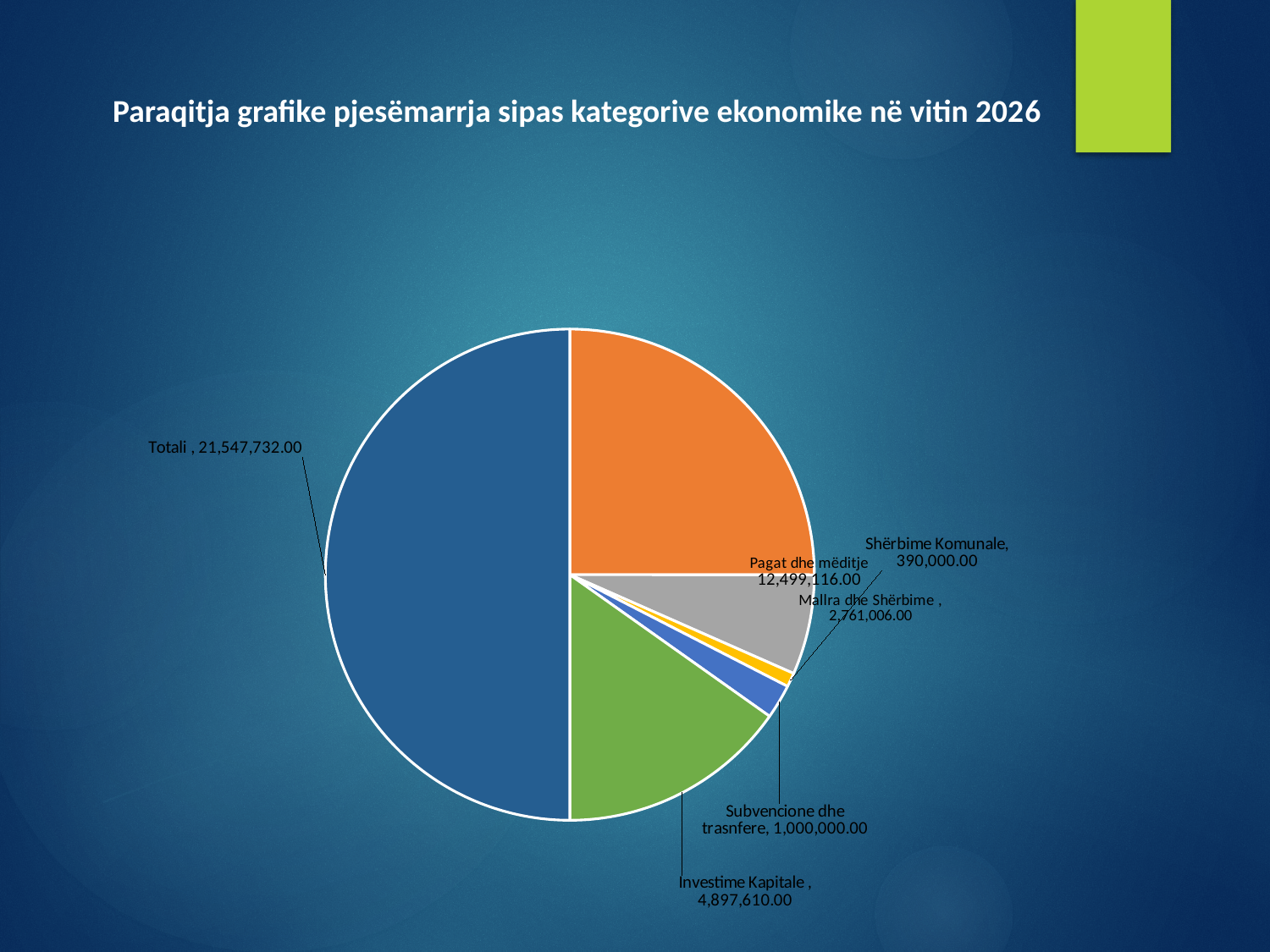
What is the value shown for Pagat dhe mëditje? 12,499,116.00 What is the value shown for Investime Kapitale? 4,897,610.00 Which slice of the pie has the largest value? Totali What is the title of the chart on the slide? Paraqitja grafike pjesëmarrja sipas kategorive ekonomike në vitin 2026 Which slice of the pie has the smallest value? Shërbime Komunale What is the value shown for Mallra dhe Shërbime? 2,761,006.00 How many slices does the pie chart have? 6 Which is larger, Investime Kapitale or Mallra dhe Shërbime? Investime Kapitale What is the value shown for Subvencione dhe trasnfere? 1,000,000.00 What is the difference between the values for Pagat dhe mëditje and Investime Kapitale? 7,601,506.00 What is the value shown for Shërbime Komunale? 390,000.00 What type of chart is shown on the slide? Pie chart